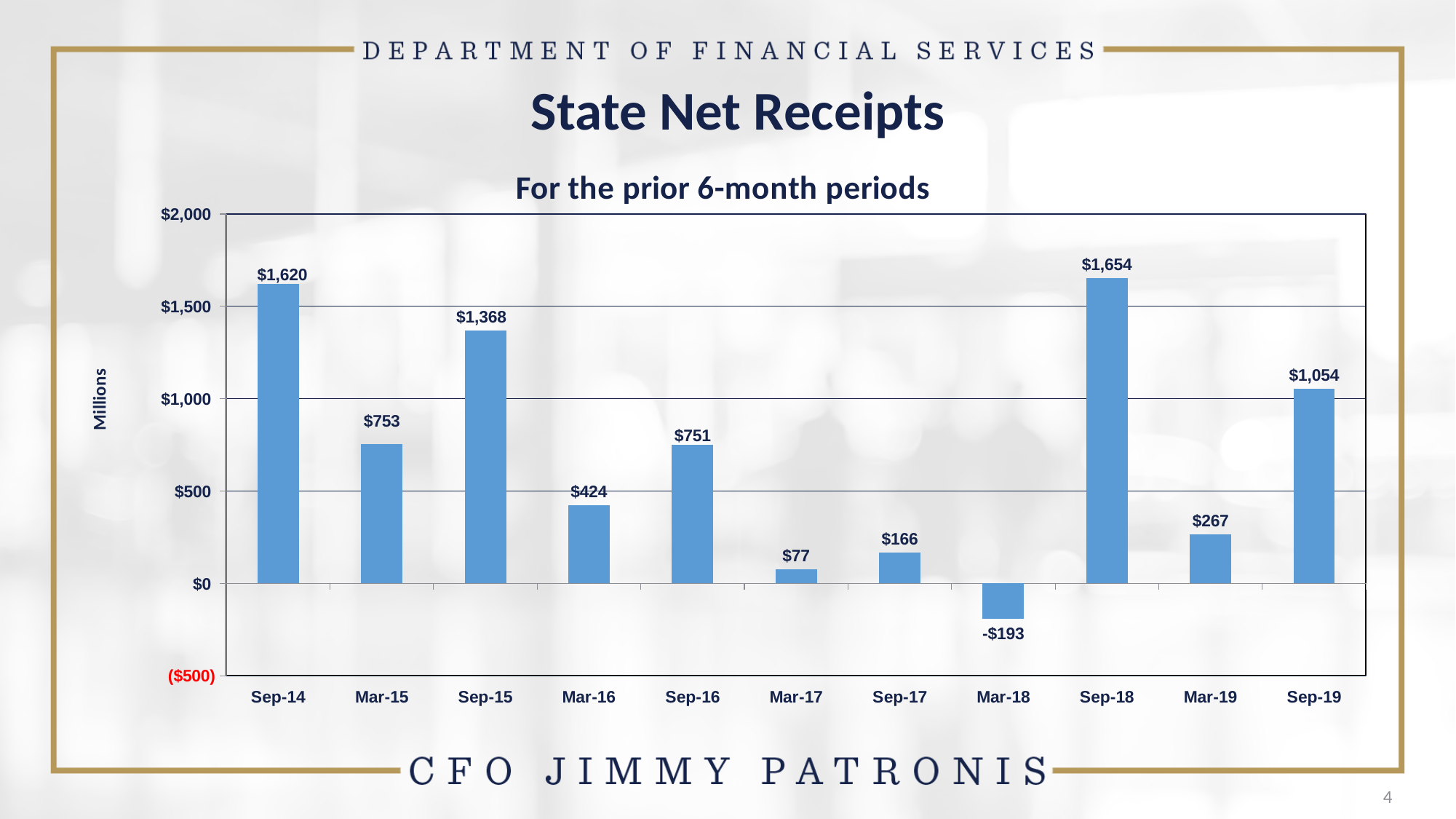
What is the value for Sep-14? $1,620 What is the chart's subtitle? For the prior 6-month periods How many periods are shown on the x axis? 11 What is the value for Sep-19? $1,054 Which is larger, the value for Sep-15 or the value for Sep-19? Sep-15 Which period has the highest value? Sep-18 What is the difference between the values for Mar-15 and Sep-16? $2 What is the value for Mar-18? -$193 What is the difference between the values for Sep-18 and Sep-14? $34 What kind of chart is shown on the slide? bar chart Which period has the lowest value? Mar-18 Is the value for Mar-16 greater or less than $500? less